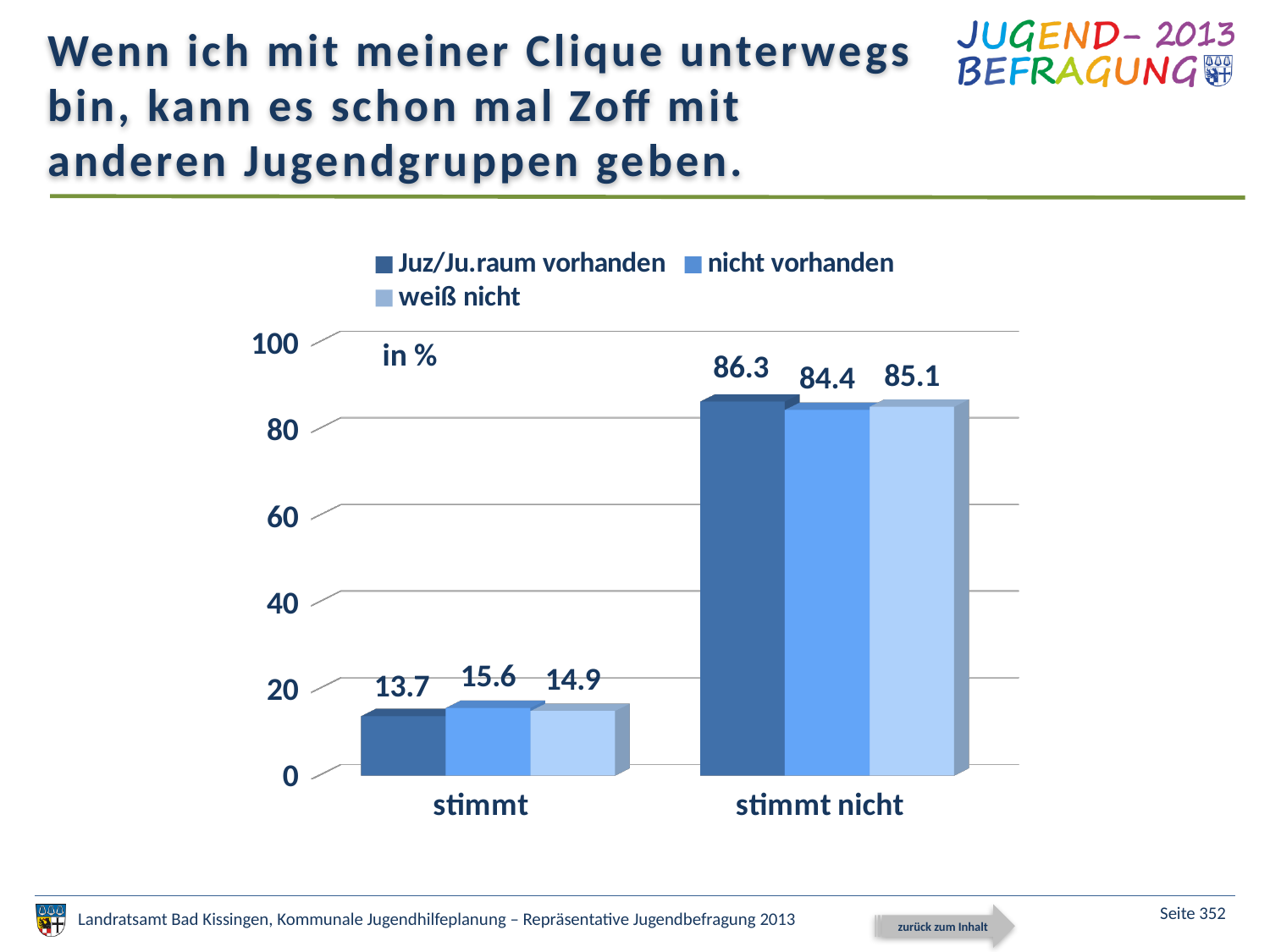
What is the difference between the "Juz/Ju.raum vorhanden" values for "stimmt nicht" and "stimmt"? 72.6 What is the value for "nicht vorhanden" in the "stimmt nicht" category? 84.4 How many categories are shown on the x axis? 2 Which is larger: the "weiß nicht" value for "stimmt" or the "nicht vorhanden" value for "stimmt"? nicht vorhanden What kind of chart is shown on the slide? bar chart What is the value for "Juz/Ju.raum vorhanden" in the "stimmt" category? 13.7 Is the value for "weiß nicht" in the "stimmt nicht" category greater or less than 80? greater Which series has the highest value in the "stimmt" category? nicht vorhanden How many series does the legend list? 3 What is the value for "weiß nicht" in the "stimmt" category? 14.9 Which series has the lowest value in the "stimmt nicht" category? nicht vorhanden What is the value for "Juz/Ju.raum vorhanden" in the "stimmt nicht" category? 86.3